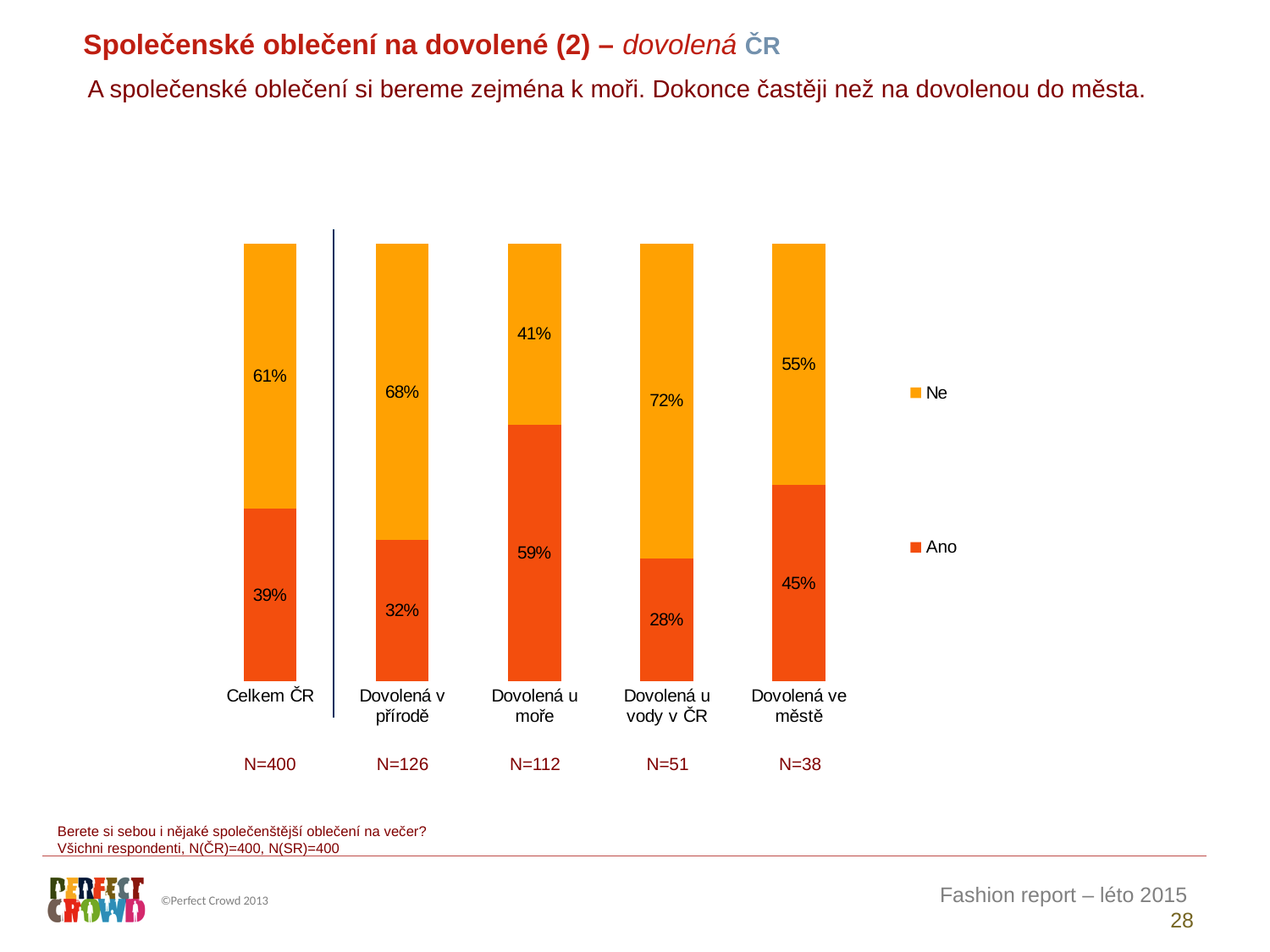
What is the 'Ne' value for Dovolená ve městě? 55% Which category has the highest 'Ano' value? Dovolená u moře What kind of chart is shown on the slide? Stacked bar chart How many categories are shown on the x axis? 5 Which is larger, the 'Ne' value for Dovolená v přírodě or the 'Ne' value for Celkem ČR? Dovolená v přírodě What is the sample size (N) shown for Dovolená u moře? N=112 Which category has the lowest 'Ano' value? Dovolená u vody v ČR What is the difference between the 'Ano' values for Dovolená u moře and Dovolená ve městě? 14% What is the 'Ano' value for Dovolená u moře? 59% What is the 'Ne' value for Dovolená u vody v ČR? 72% What is the 'Ano' value for Celkem ČR? 39% How many series does the legend list? 2